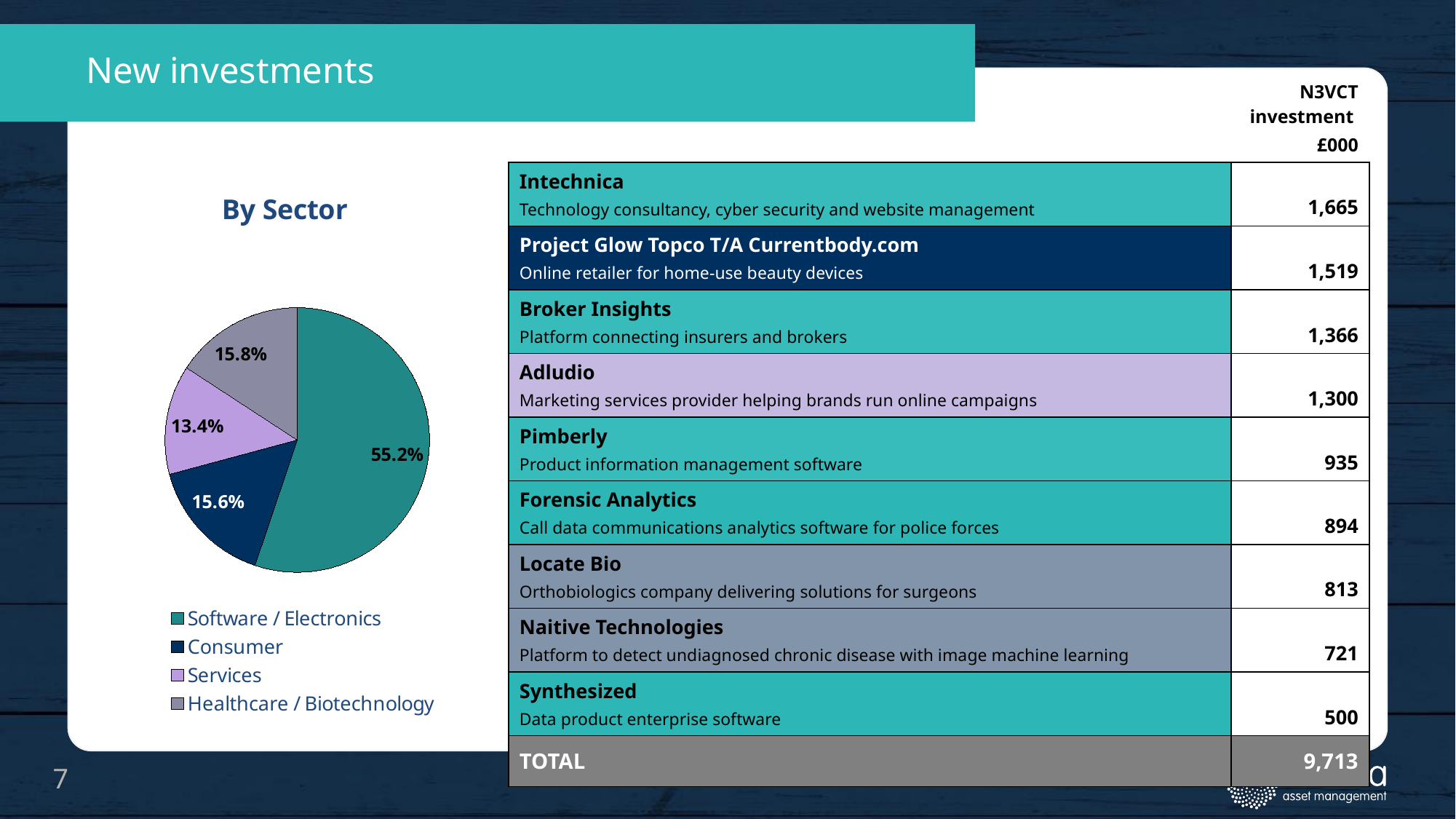
What is the difference in percentage points between the Software / Electronics slice and the Services slice? 41.8 What share of the pie chart does Software / Electronics represent? 55.2% Which sector has the largest slice in the pie chart? Software / Electronics Which sector has the smallest slice in the pie chart? Services How many slices does the pie chart have? 4 How many entries does the pie chart legend list? 4 What share of the pie chart does Healthcare / Biotechnology represent? 15.8% What is the title of the pie chart? By Sector What type of chart is shown under the title "By Sector"? pie chart Which is larger in the pie chart, the Software / Electronics slice or the Consumer slice? Software / Electronics What share of the pie chart does Consumer represent? 15.6%